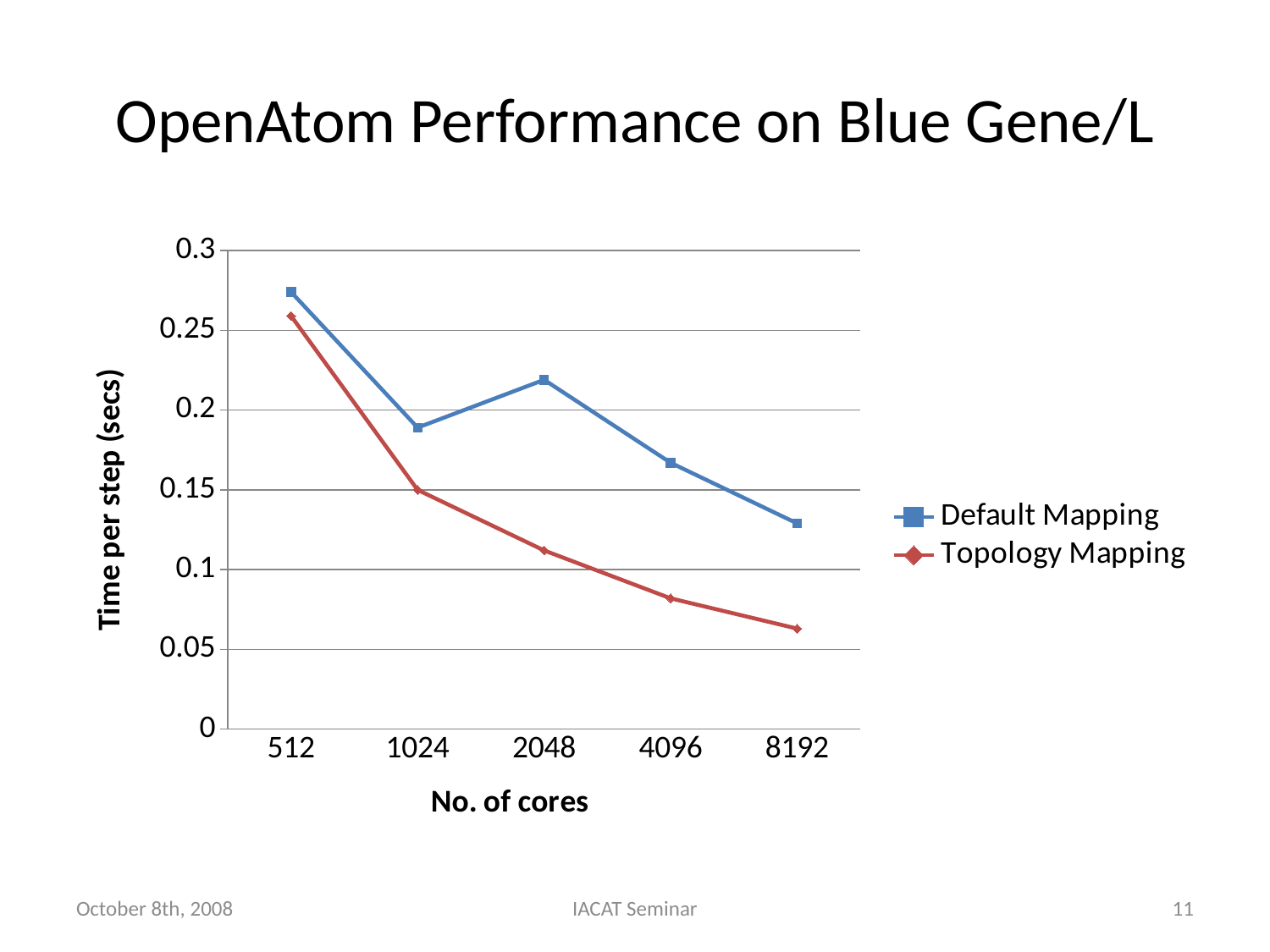
What is the label of the y axis? Time per step (secs) How many series does the legend list? 2 Is the Default Mapping value at 8192 cores greater or less than 0.15? less Is the Default Mapping value at 512 cores greater or less than 0.25? greater Does the Topology Mapping line rise or fall as the number of cores increases? fall Is the Topology Mapping value at 4096 cores greater or less than 0.1? less Which series has the higher time per step at 4096 cores, Default Mapping or Topology Mapping? Default Mapping What kind of chart is shown on the slide? Line chart At which number of cores is the Topology Mapping time per step lowest? 8192 Does the Default Mapping line rise or fall between 1024 and 2048 cores? rise At which number of cores is the Default Mapping time per step highest? 512 How many core counts are plotted along the x axis? 5